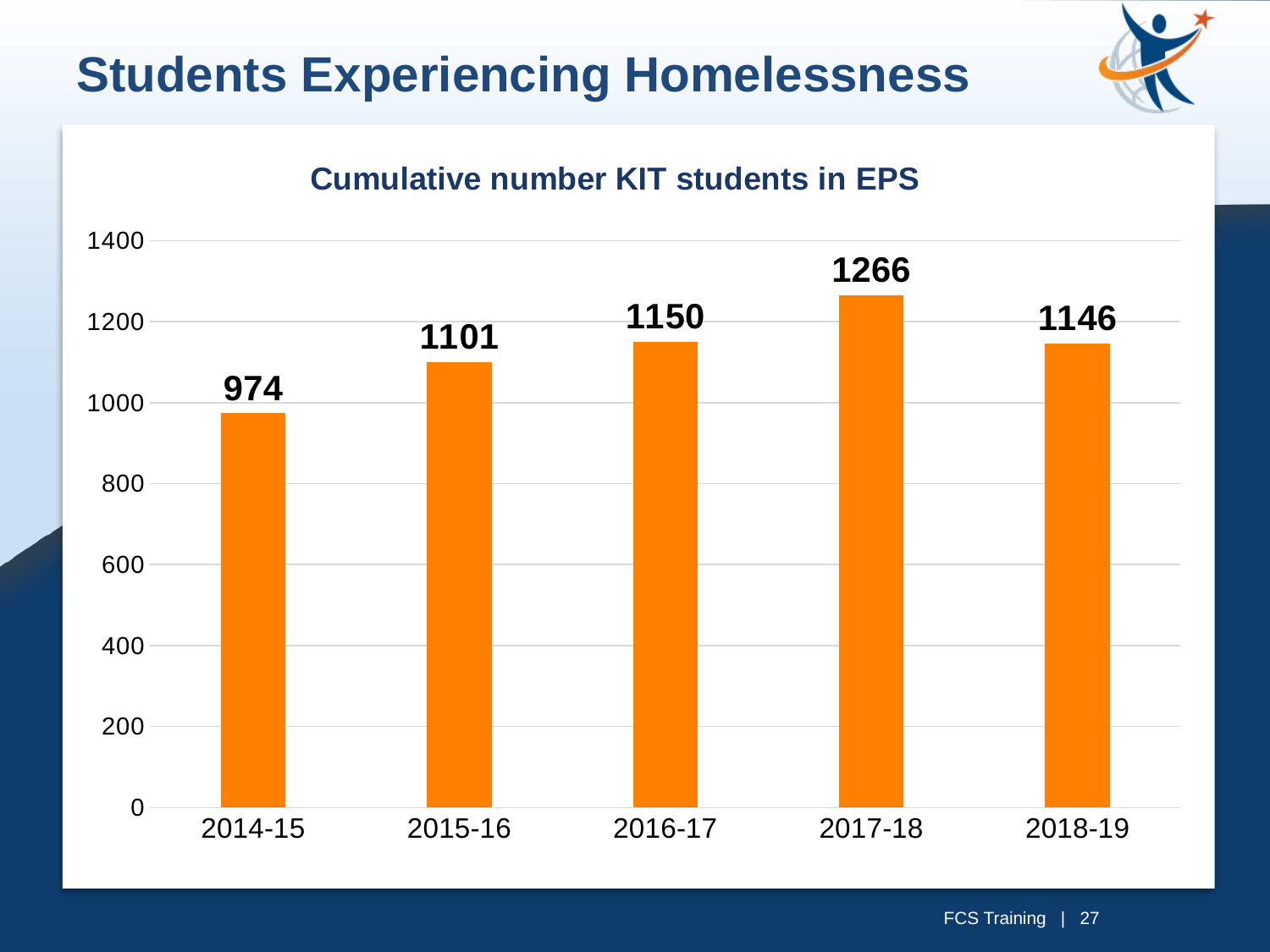
What is the difference between the values for 2015-16 and 2014-15? 127 What kind of chart is shown on the slide? bar chart What is the difference between the values for 2017-18 and 2018-19? 120 What is the value shown for 2017-18? 1266 Is the value for 2014-15 greater or less than 1000? less What is the title of the chart? Cumulative number KIT students in EPS Which school year has the highest cumulative number of KIT students? 2017-18 Which school year has the lowest cumulative number of KIT students? 2014-15 What is the cumulative number of KIT students in EPS for 2014-15? 974 What is the value shown for 2018-19? 1146 How many school years are shown on the chart? 5 Which is larger, the value for 2016-17 or the value for 2015-16? 2016-17